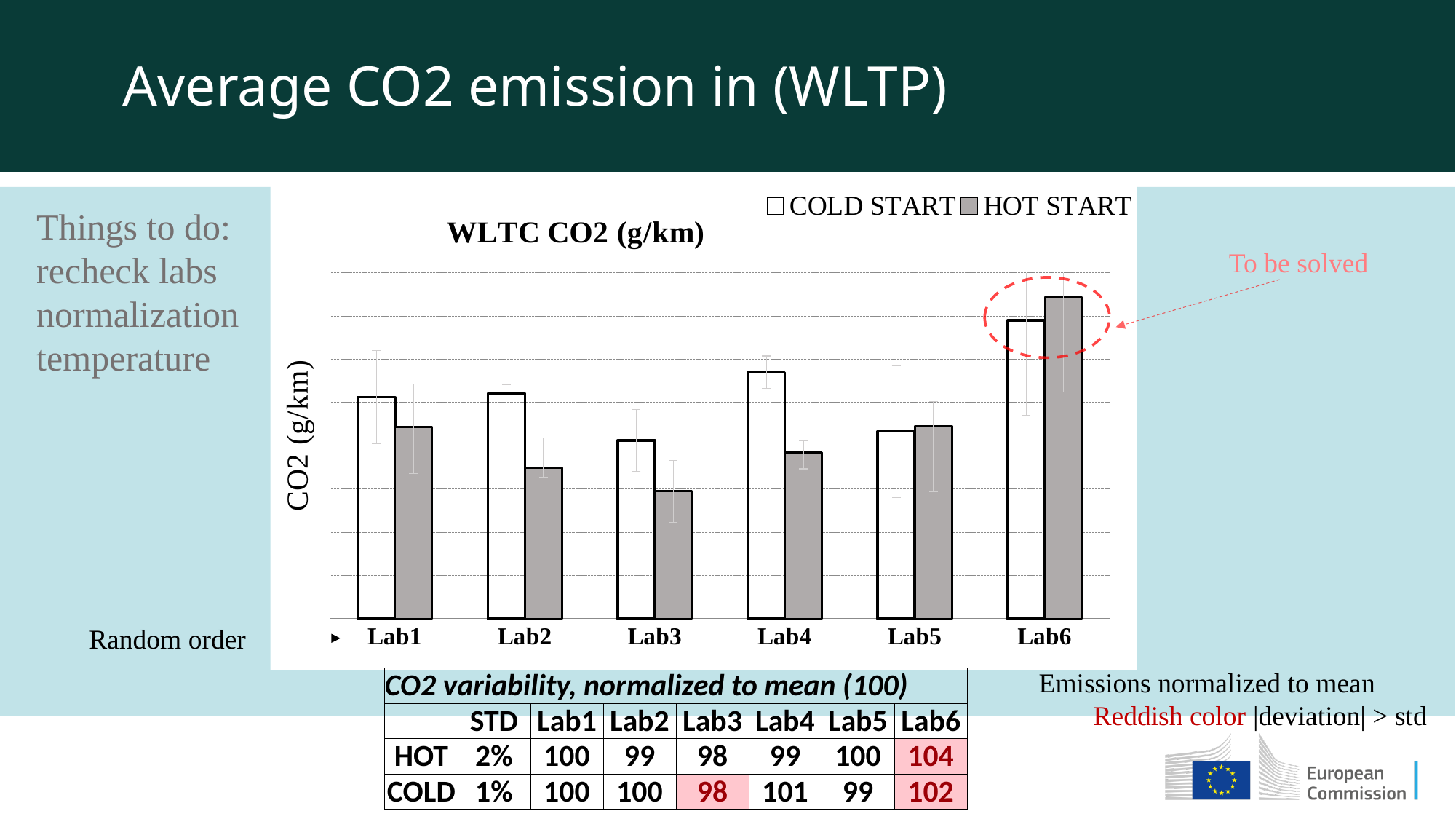
Which is larger, the HOT START value for Lab2 or for Lab3? Lab2 Which is larger, the COLD START value for Lab4 or for Lab2? Lab4 Which lab has the highest HOT START value? Lab6 For Lab6, which is larger, the COLD START or the HOT START value? HOT START How many series does the chart legend list? 2 Which lab has the highest COLD START value? Lab6 How many labs are shown on the x axis of the chart? 6 What is the title of the chart? WLTC CO2 (g/km) What are the two series named in the chart legend? COLD START and HOT START Which lab has the lowest HOT START value? Lab3 What kind of chart is shown on the slide? bar chart